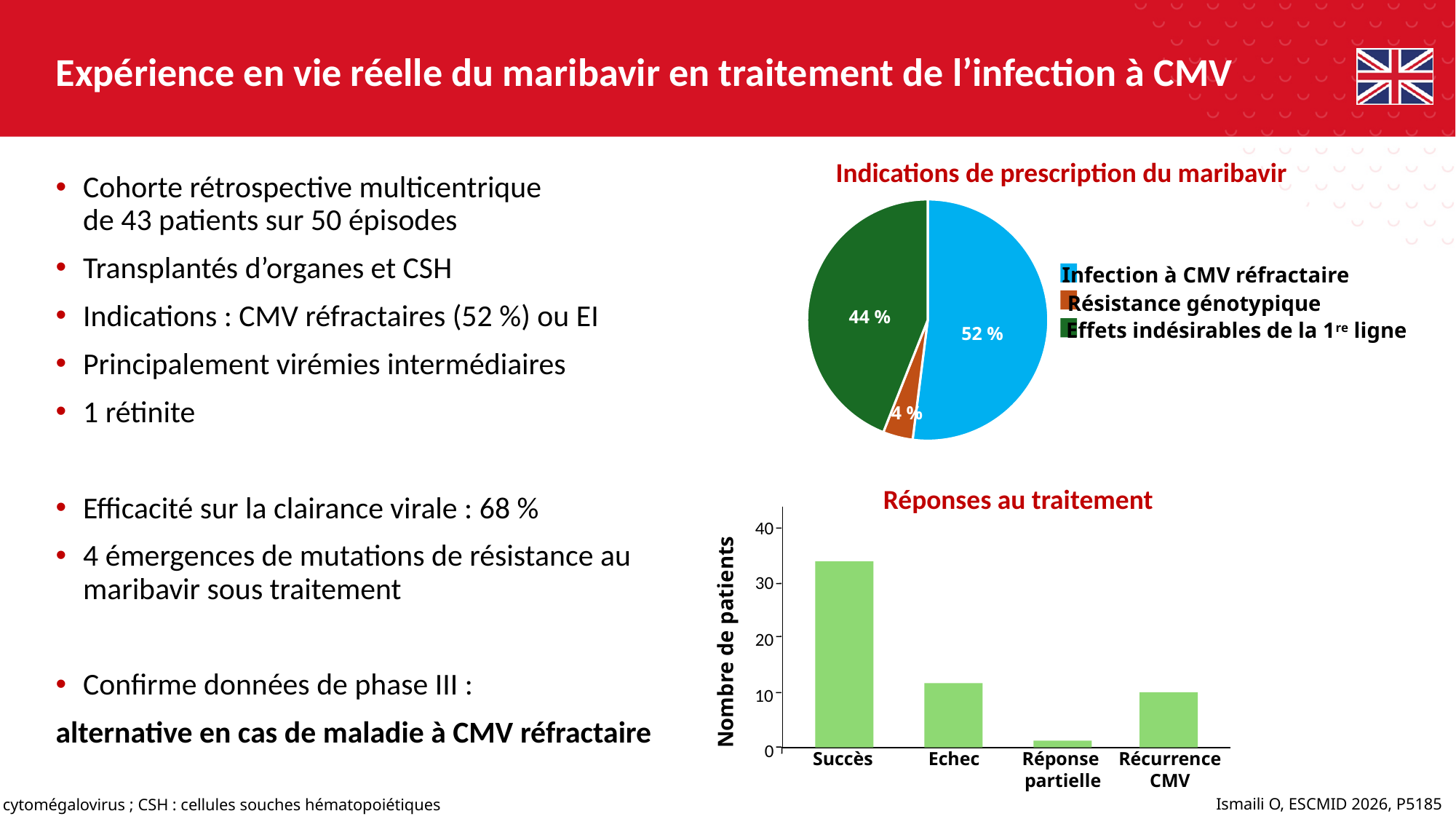
What kind of chart is 'Réponses au traitement'? Bar chart In the 'Indications de prescription du maribavir' pie chart, what share is labelled for Effets indésirables de la 1re ligne? 44 % In the 'Réponses au traitement' chart, is the value for Succès greater or less than 30? greater In the 'Indications de prescription du maribavir' pie chart, which slice is the smallest? Résistance génotypique How many entries does the legend of the 'Indications de prescription du maribavir' pie chart list? 3 In the 'Réponses au traitement' chart, which category has the lowest number of patients? Réponse partielle In the 'Réponses au traitement' chart, which category has the highest number of patients? Succès In the 'Indications de prescription du maribavir' pie chart, what share is labelled for Résistance génotypique? 4 % In the 'Indications de prescription du maribavir' pie chart, which slice is the largest? Infection à CMV réfractaire How many categories are shown on the x axis of the 'Réponses au traitement' chart? 4 In the 'Indications de prescription du maribavir' pie chart, what share is labelled for Infection à CMV réfractaire? 52 % In the 'Indications de prescription du maribavir' pie chart, what is the difference between the Infection à CMV réfractaire share and the Effets indésirables de la 1re ligne share? 8 %